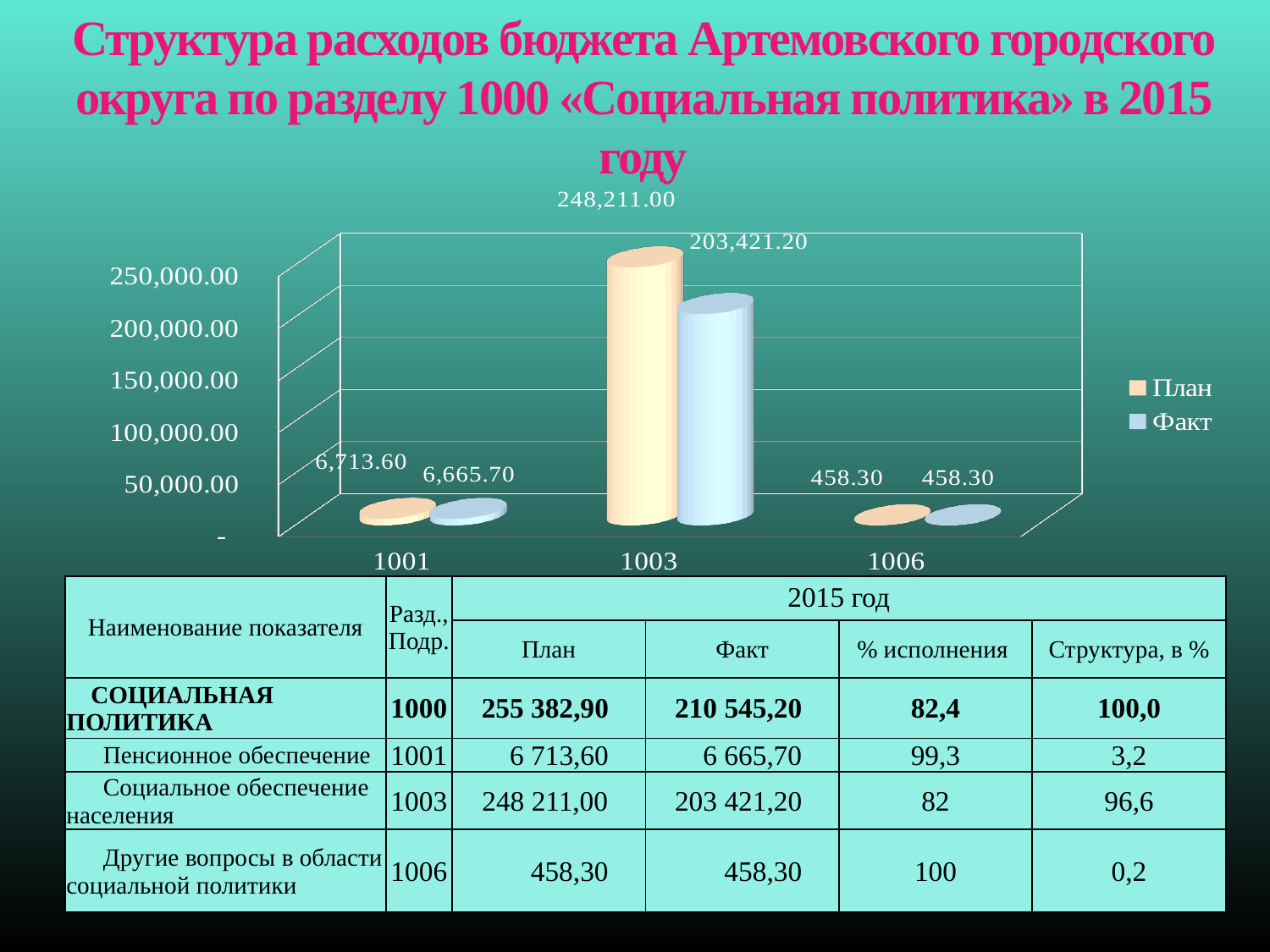
Which category has the lowest Факт value? 1006 Which category has the highest План value? 1003 What is the difference between the План and Факт values for category 1001? 47.90 How many categories are shown on the x axis of the chart? 3 What is the Факт value for category 1003? 203,421.20 What is the План value for category 1001? 6,713.60 Which is larger for category 1003, the План value or the Факт value? План What is the План value for category 1003? 248,211.00 What kind of chart is shown on the slide? Bar chart What is the difference between the План and Факт values for category 1003? 44,789.80 How many series does the chart legend list? 2 What is the Факт value for category 1006? 458.30